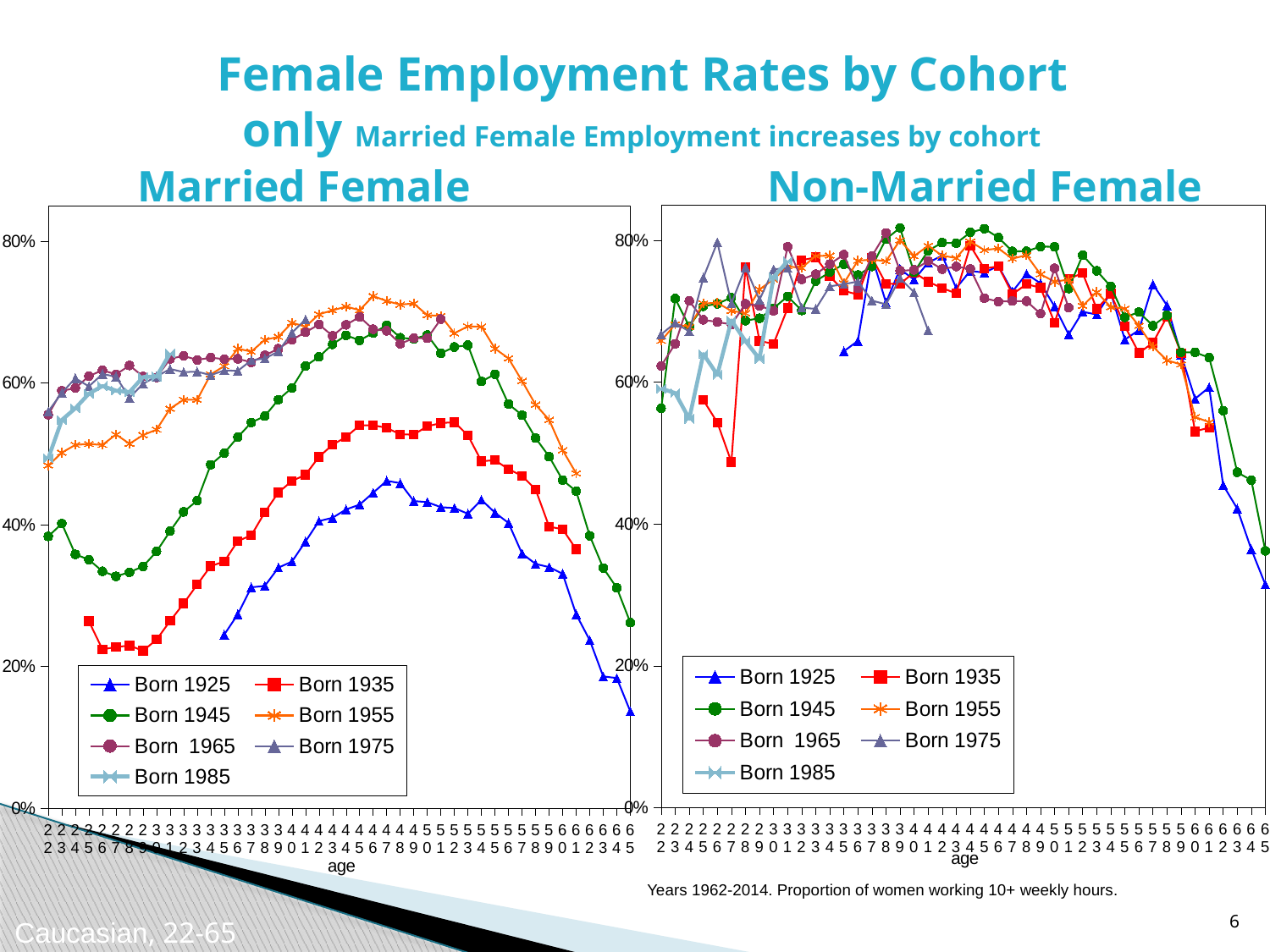
In the Married Female chart, at age 40, which is larger: Born 1955 or Born 1925? Born 1955 In the Married Female chart, does the Born 1925 line rise or fall from age 50 to age 65? fall In the Married Female chart, which cohort has the lowest employment rates across the ages shown? Born 1925 How many series does the legend of the Non-Married Female chart list? 7 In the Non-Married Female chart, at age 28, which is larger: Born 1945 or Born 1935? Born 1935 In the Non-Married Female chart, is the value for Born 1935 at age 28 greater or less than 60%? greater In the Married Female chart, is the value for Born 1925 at age 65 greater or less than 20%? less In the Non-Married Female chart, is the value for Born 1925 at age 65 greater or less than 40%? less What is the title of the left chart? Married Female What kind of chart is the Married Female chart? line chart